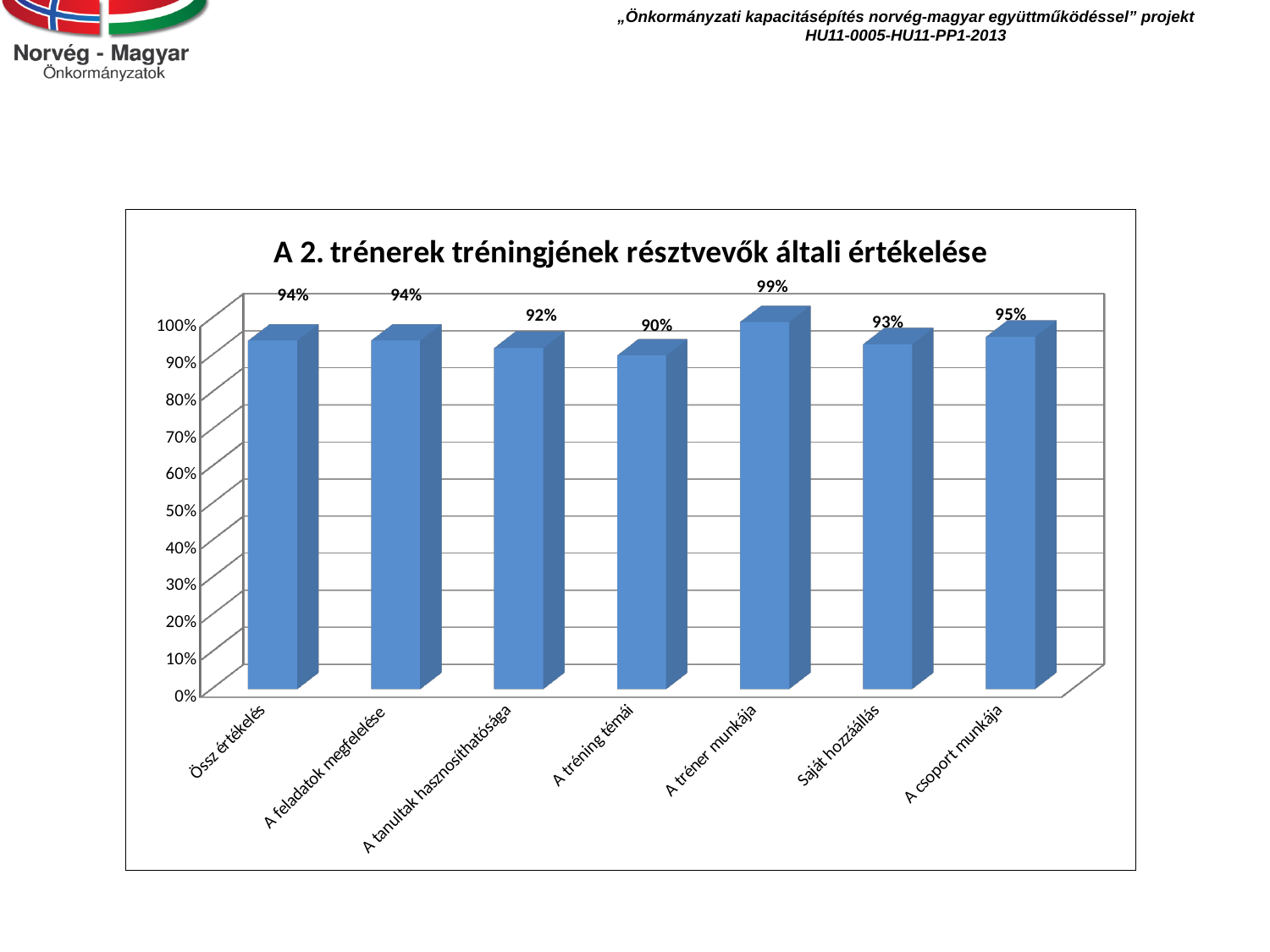
What kind of chart is shown on the slide? Bar chart What is the value for "Saját hozzáállás"? 93% What is the value for "A csoport munkája"? 95% Which is larger, the value for "A csoport munkája" or the value for "Saját hozzáállás"? A csoport munkája Which category has the highest value? A tréner munkája What is the difference between the values for "A tréner munkája" and "A tréning témái"? 9% Which category has the lowest value? A tréning témái What is the title of the chart? A 2. trénerek tréningjének résztvevők általi értékelése How many categories are shown on the x axis? 7 What is the value for "A tréner munkája"? 99% What is the value for "A tréning témái"? 90% What is the difference between the values for "A tanultak hasznosíthatósága" and "Össz értékelés"? 2%